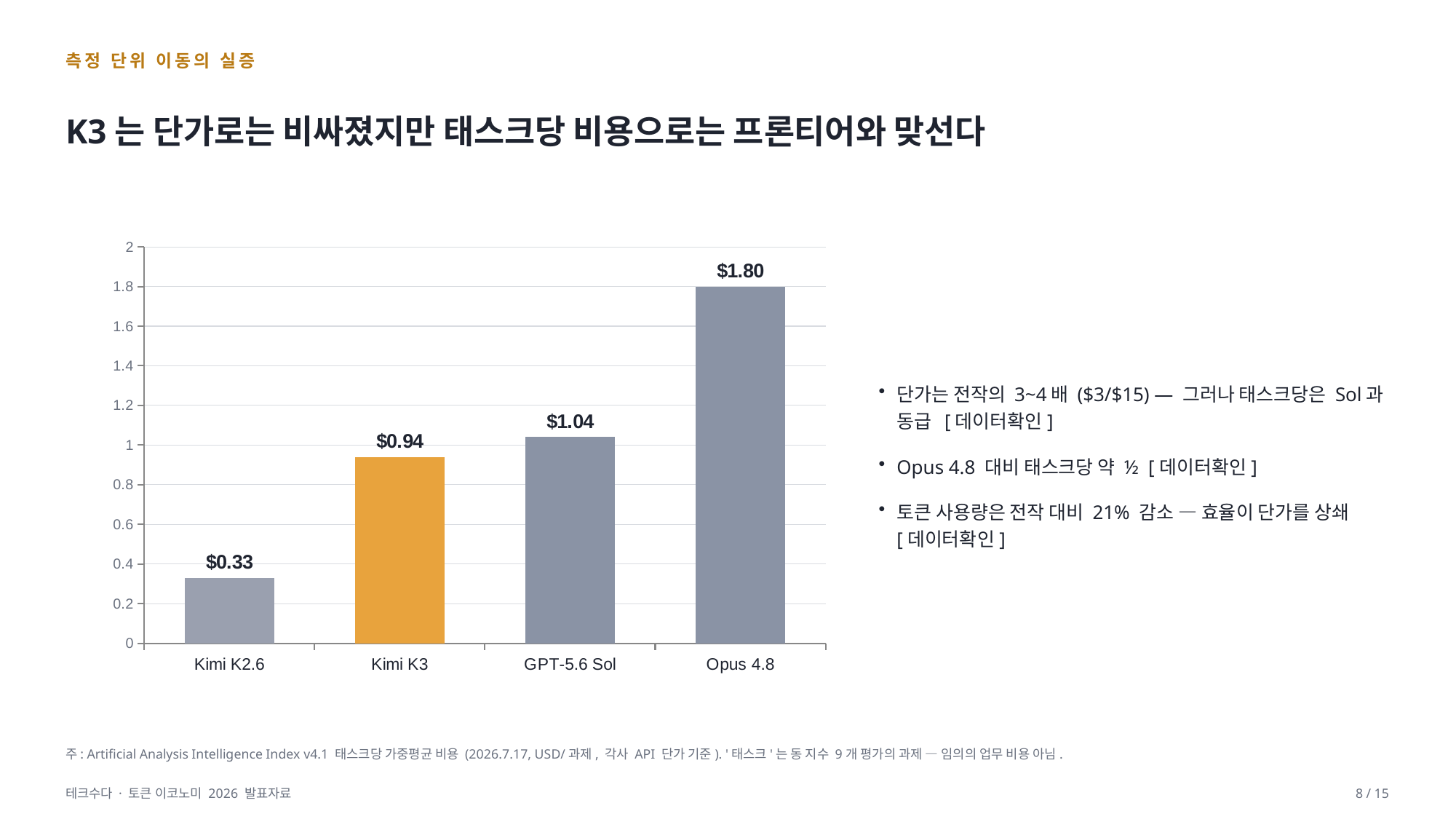
Which bar is highlighted in orange? Kimi K3 What is the value for Opus 4.8? $1.80 What is the difference between the values for Opus 4.8 and Kimi K3? $0.86 How many categories are shown in the chart? 4 What is the difference between the values for Kimi K3 and Kimi K2.6? $0.61 What is the value for Kimi K2.6? $0.33 What kind of chart is shown on the slide? Bar chart Which category has the lowest value? Kimi K2.6 Which is larger, the value for GPT-5.6 Sol or the value for Kimi K3? GPT-5.6 Sol What is the value for Kimi K3? $0.94 Which category has the highest value? Opus 4.8 What is the value for GPT-5.6 Sol? $1.04